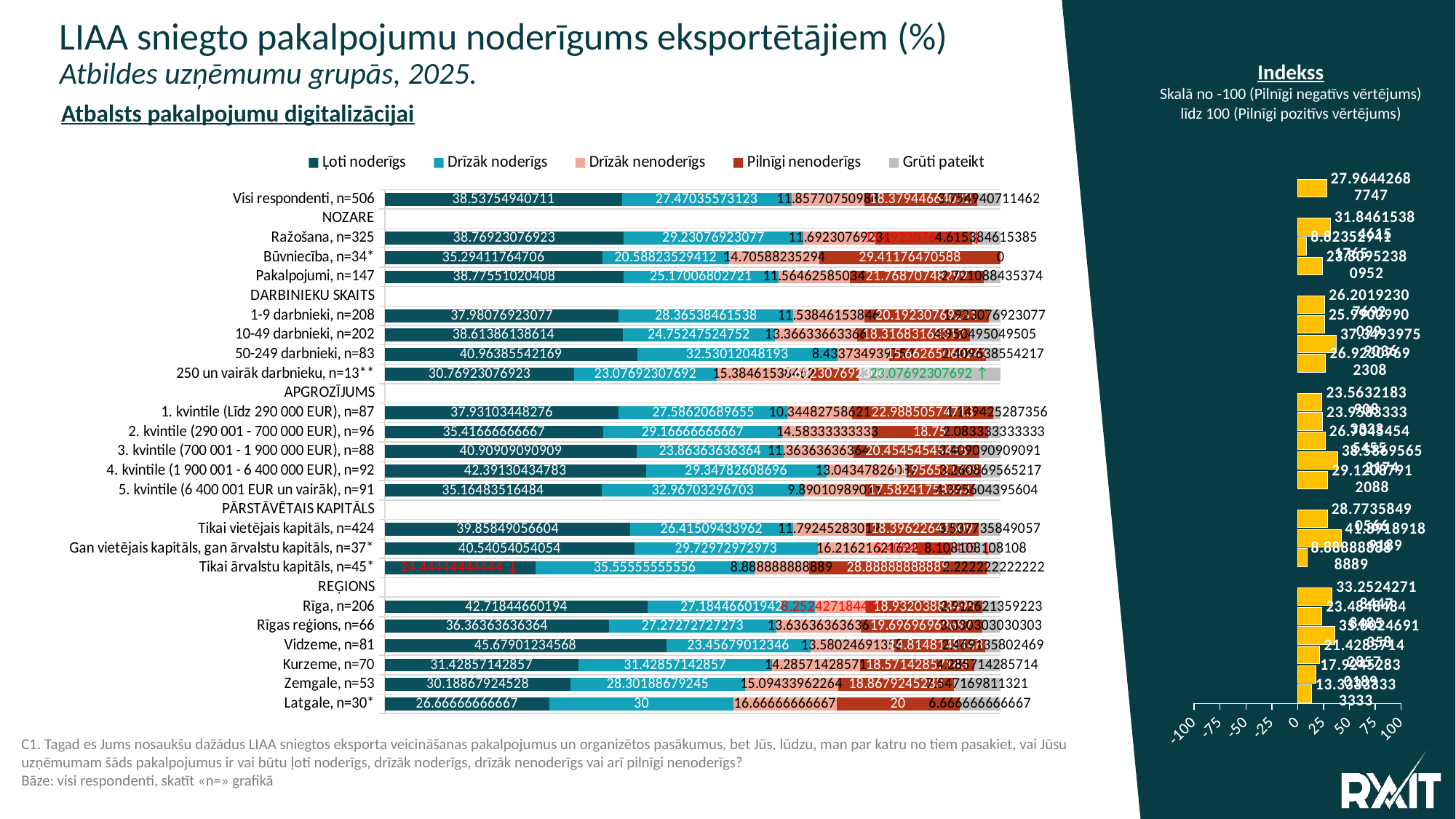
In the 'Atbalsts pakalpojumu digitalizācijai' chart, which has the larger 'Ļoti noderīgs' value: Rīga, n=206 or Rīgas reģions, n=66? Rīga, n=206 In the 'Atbalsts pakalpojumu digitalizācijai' chart, which region under REĢIONS has the highest 'Ļoti noderīgs' value? Vidzeme, n=81 In the 'Atbalsts pakalpojumu digitalizācijai' chart, what is the 'Pilnīgi nenoderīgs' value for Būvniecība, n=34*? 29.41176470588 In the 'Atbalsts pakalpojumu digitalizācijai' chart, which group has the lowest 'Ļoti noderīgs' value? Tikai ārvalstu kapitāls, n=45* In the 'Atbalsts pakalpojumu digitalizācijai' chart, what is the 'Ļoti noderīgs' value for Vidzeme, n=81? 45.67901234568 In the 'Atbalsts pakalpojumu digitalizācijai' chart, what is the 'Grūti pateikt' value for Būvniecība, n=34*? 0 How many series does the legend of the 'Atbalsts pakalpojumu digitalizācijai' chart list? 5 In the 'Atbalsts pakalpojumu digitalizācijai' chart, what is the difference between the 'Drīzāk noderīgs' and 'Pilnīgi nenoderīgs' values for Latgale, n=30*? 10 In the 'Atbalsts pakalpojumu digitalizācijai' chart, what is the 'Pilnīgi nenoderīgs' value for Latgale, n=30*? 20 What kind of chart is used for 'Atbalsts pakalpojumu digitalizācijai'? Stacked bar chart In the 'Atbalsts pakalpojumu digitalizācijai' chart, what is the 'Drīzāk noderīgs' value for Latgale, n=30*? 30 What is the first entry in the legend of the 'Atbalsts pakalpojumu digitalizācijai' chart? Ļoti noderīgs